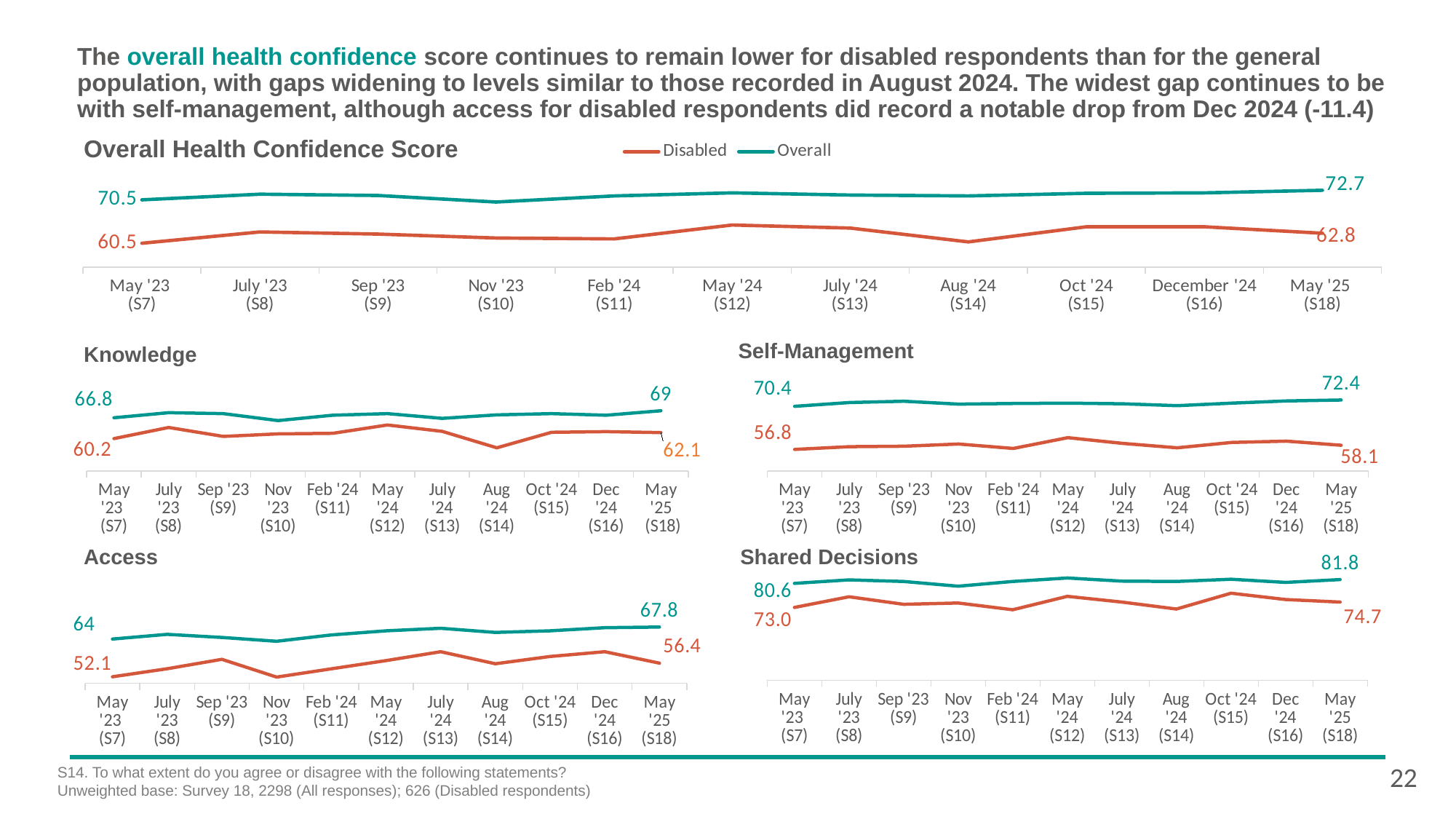
In the Access chart, what is the Disabled score for May '25 (S18)? 56.4 In the Shared Decisions chart, what is the Overall score for May '23 (S7)? 80.6 In the Overall Health Confidence Score chart, what is the Overall score for May '25 (S18)? 72.7 In the Access chart, by how much did the Disabled score change from May '23 (S7) to May '25 (S18)? 4.3 In the Self-Management chart, which series has the higher score in May '25 (S18), Disabled or Overall? Overall In the Knowledge chart, what is the Overall score for May '25 (S18)? 69 How many survey time points are shown on the x axis of the Overall Health Confidence Score chart? 11 How many series does the legend of the Overall Health Confidence Score chart list? 2 What kind of chart is the Self-Management chart? Line chart In the Overall Health Confidence Score chart, what is the difference between the Overall and Disabled scores in May '25 (S18)? 9.9 In the Self-Management chart, what is the Disabled score for May '23 (S7)? 56.8 In the Overall Health Confidence Score chart, what is the Disabled score for May '23 (S7)? 60.5